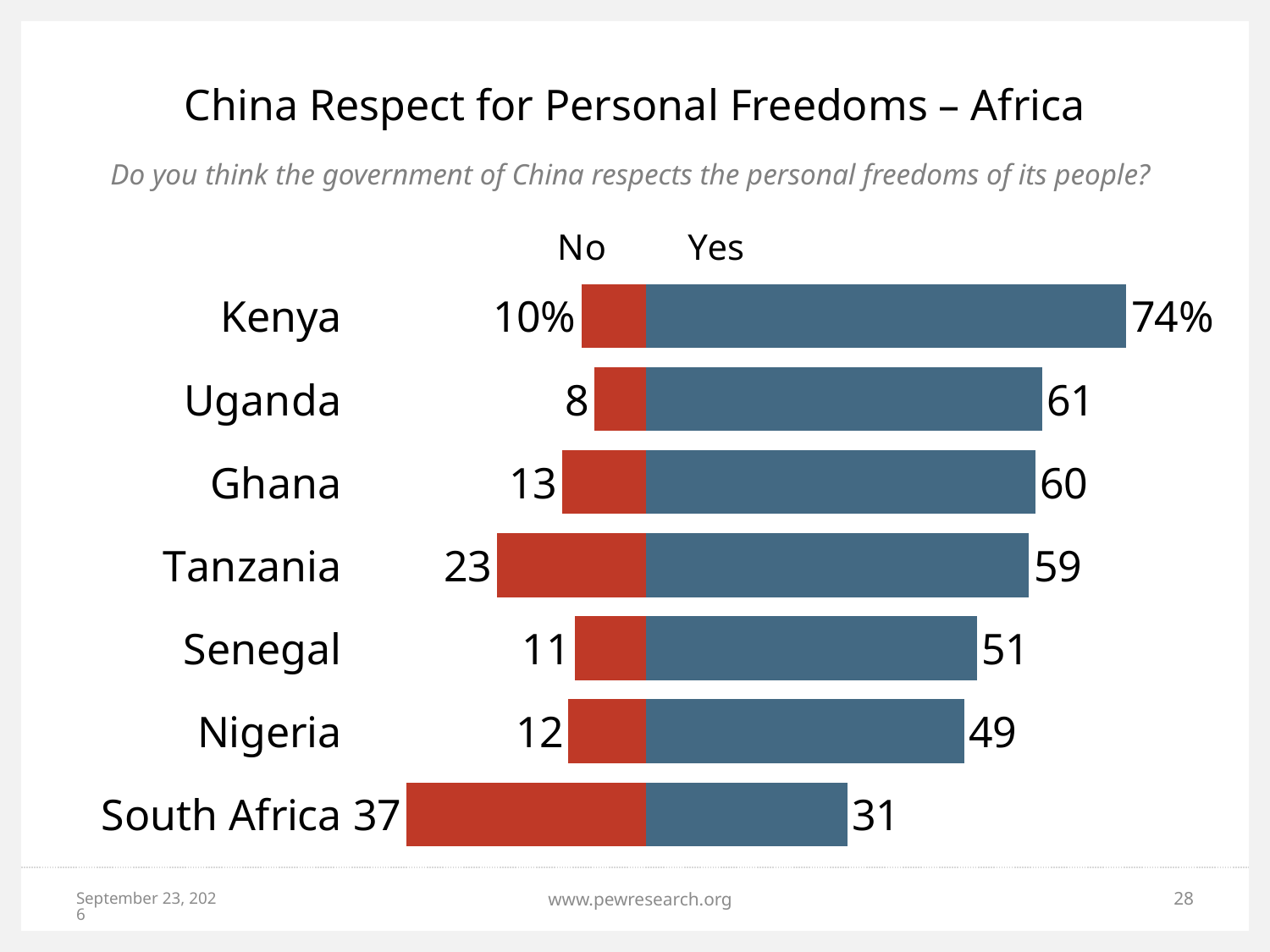
Which is larger for Nigeria, the Yes value or the No value? Yes Which country has the highest No value? South Africa What percentage of respondents in Kenya answered Yes? 74% What is the No value for South Africa? 37 How many countries are shown in the chart? 7 What colour represents the No responses? Red What is the Yes value for Senegal? 51 What type of chart is shown on the slide? Bar chart How many series does the chart show? 2 Which country has the lowest No value? Uganda What is the difference between the Yes and No values for Tanzania? 36 Which country has the highest Yes value? Kenya